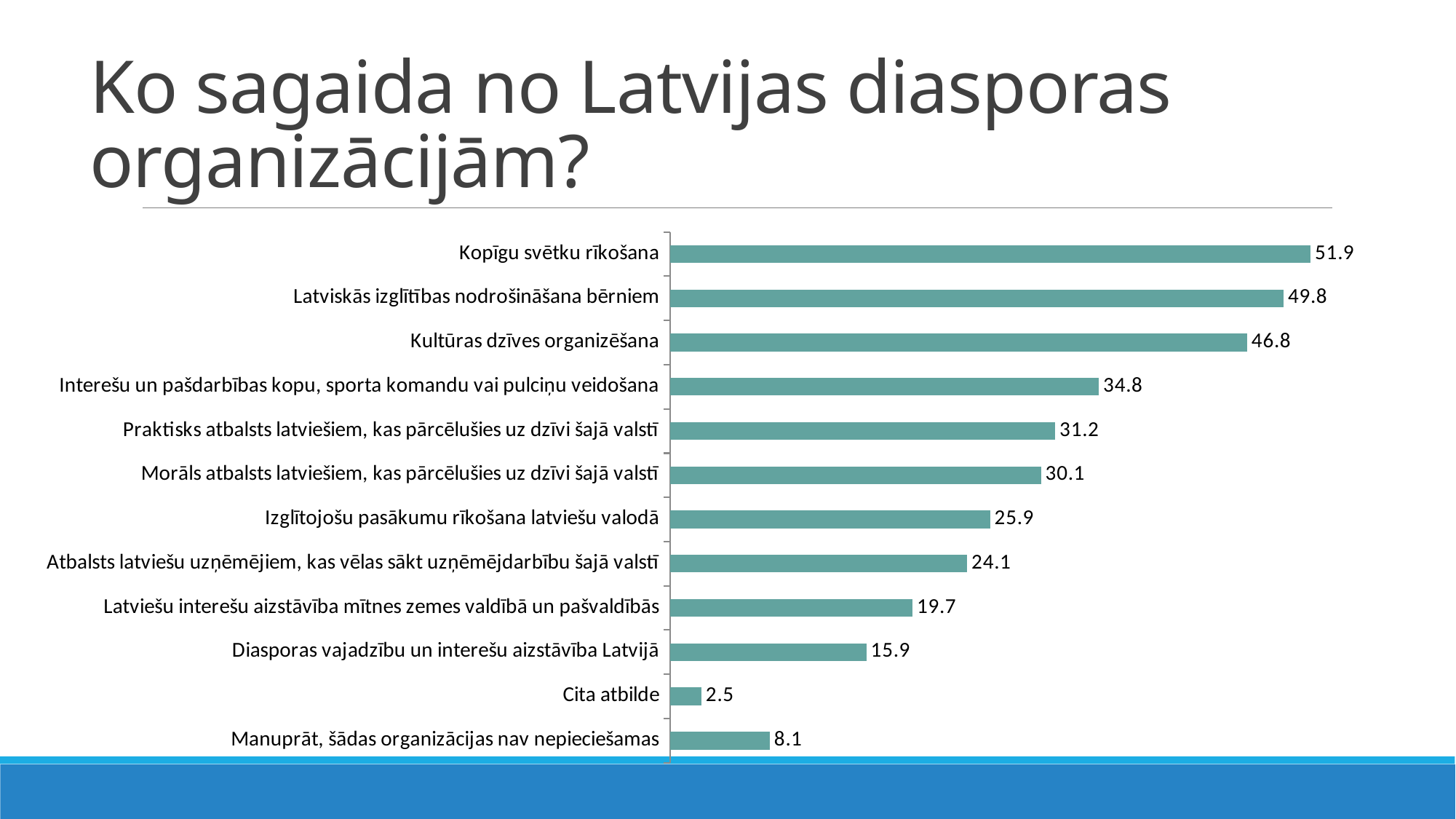
What is the value for "Diasporas vajadzību un interešu aizstāvība Latvijā"? 15.9 What is the title of the slide? Ko sagaida no Latvijas diasporas organizācijām? Which category has the highest value? Kopīgu svētku rīkošana How many categories are shown in the chart? 12 Which is larger: the value for "Cita atbilde" or for "Manuprāt, šādas organizācijas nav nepieciešamas"? Manuprāt, šādas organizācijas nav nepieciešamas Which is larger: the value for "Izglītojošu pasākumu rīkošana latviešu valodā" or for "Atbalsts latviešu uzņēmējiem, kas vēlas sākt uzņēmējdarbību šajā valstī"? Izglītojošu pasākumu rīkošana latviešu valodā Which category has the lowest value? Cita atbilde What kind of chart is shown on the slide? Bar chart What is the value for "Kopīgu svētku rīkošana"? 51.9 What is the difference between the values for "Kopīgu svētku rīkošana" and "Latviskās izglītības nodrošināšana bērniem"? 2.1 What is the value for "Morāls atbalsts latviešiem, kas pārcēlušies uz dzīvi šajā valstī"? 30.1 What is the difference between the values for "Kultūras dzīves organizēšana" and "Interešu un pašdarbības kopu, sporta komandu vai pulciņu veidošana"? 12.0